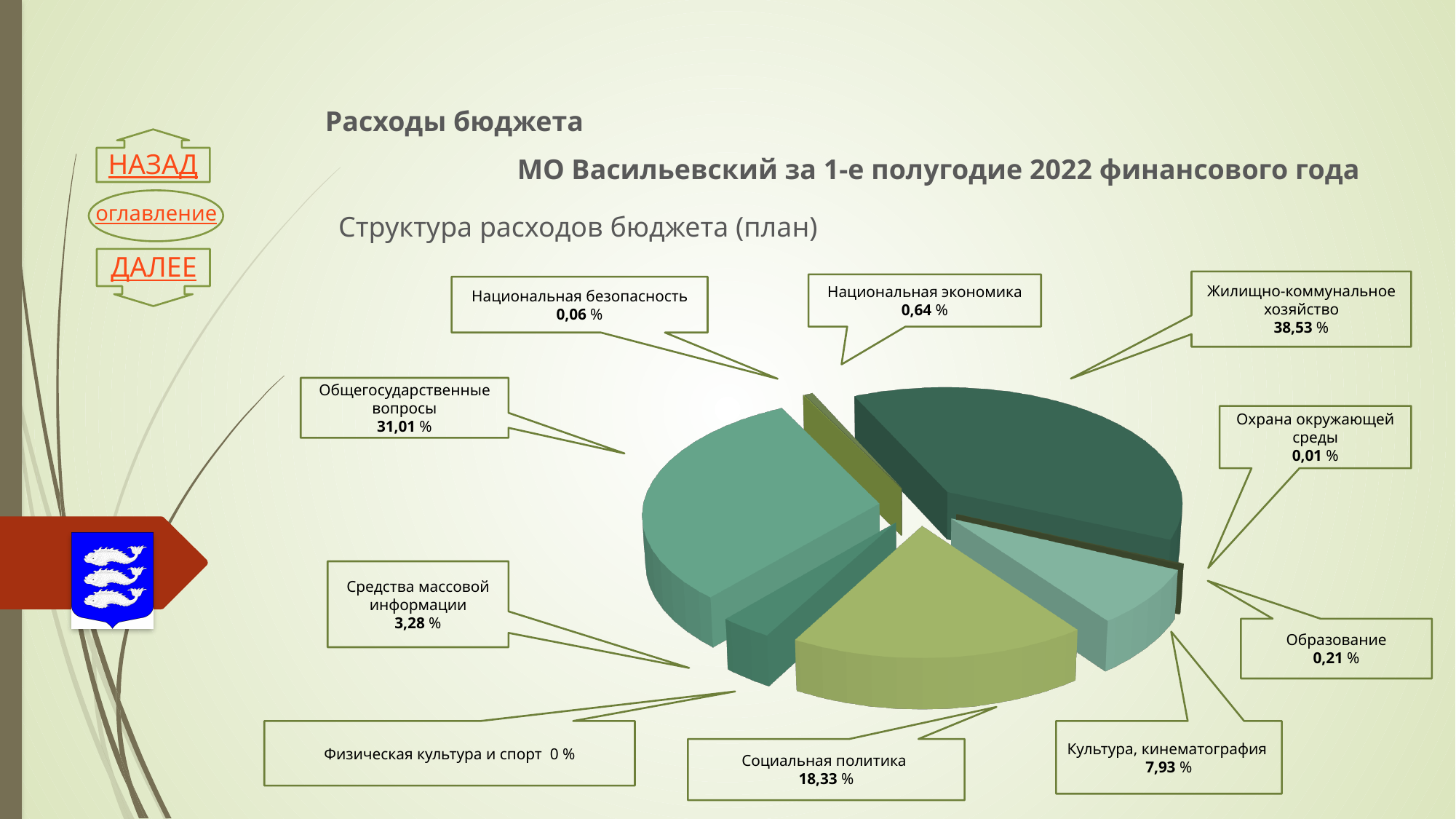
What share is shown for Охрана окружающей среды? 0,01 % What share is shown for Общегосударственные вопросы? 31,01 % What is the difference in percentage points between Жилищно-коммунальное хозяйство and Общегосударственные вопросы? 7,52 What share is shown for Средства массовой информации? 3,28 % Which category has the largest share of the planned budget expenditure? Жилищно-коммунальное хозяйство Which category has the smallest non-zero share? Охрана окружающей среды What kind of chart is shown on the slide? pie chart How many expenditure categories are labelled on the chart? 10 What share is shown for Культура, кинематография? 7,93 % What share of the budget expenditure is planned for Жилищно-коммунальное хозяйство? 38,53 % What share is shown for Социальная политика? 18,33 % Which is larger: the share for Национальная экономика or for Образование? Национальная экономика